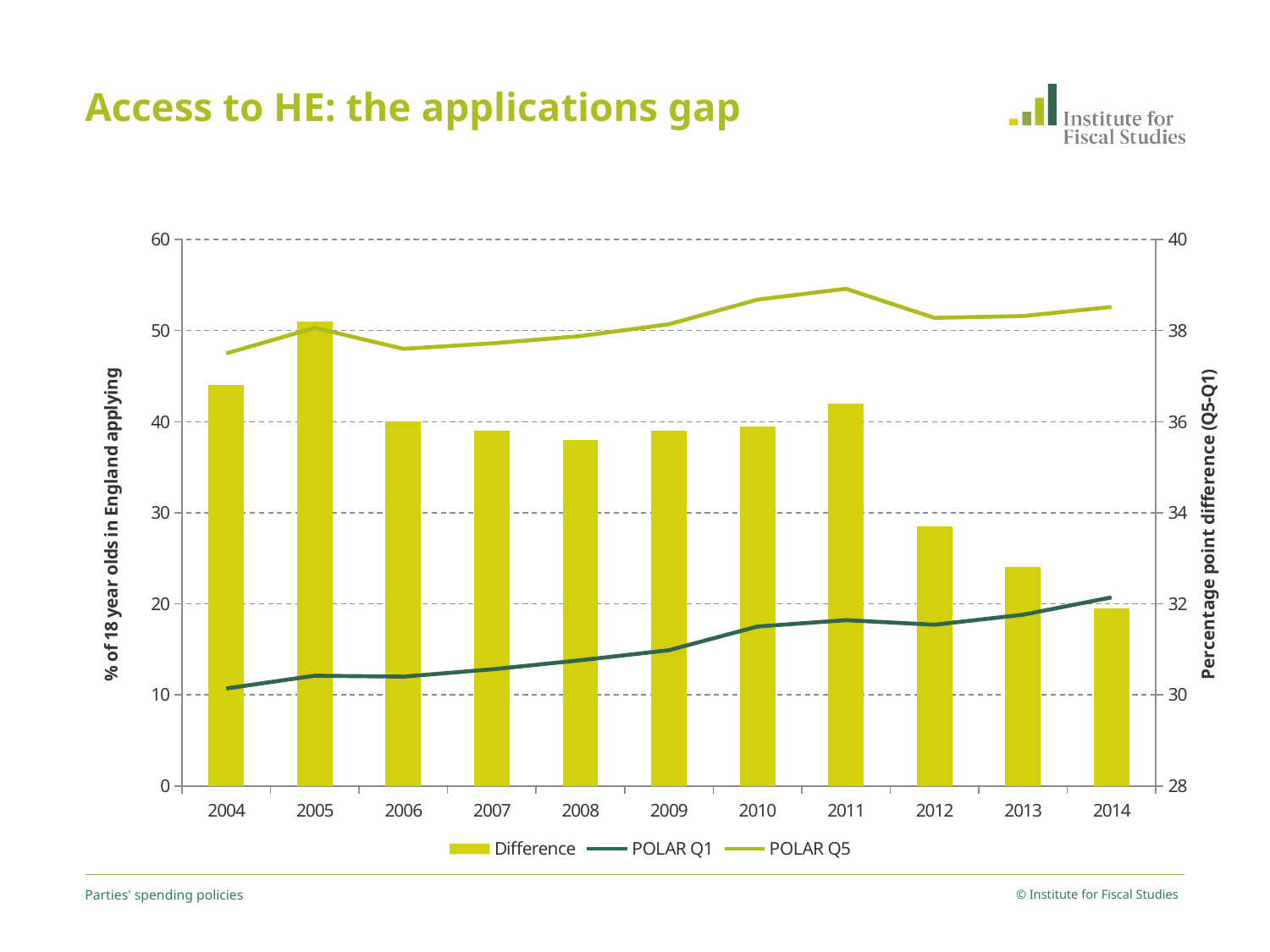
Is the Difference bar for 2012 greater or less than 30? greater Which year has the larger Difference bar, 2011 or 2012? 2011 What is the title of the slide? Access to HE: the applications gap What kind of chart is shown on the slide? A combination bar and line chart How many years are shown along the x axis? 11 Is the Difference bar for 2004 greater or less than 40? less Is the POLAR Q5 value for 2011 greater or less than 50 on the left axis? greater Does the POLAR Q1 line generally rise or fall from 2004 to 2014? rise In which year is the Difference bar lowest? 2014 In which year is the Difference bar highest? 2005 How many series does the legend list? 3